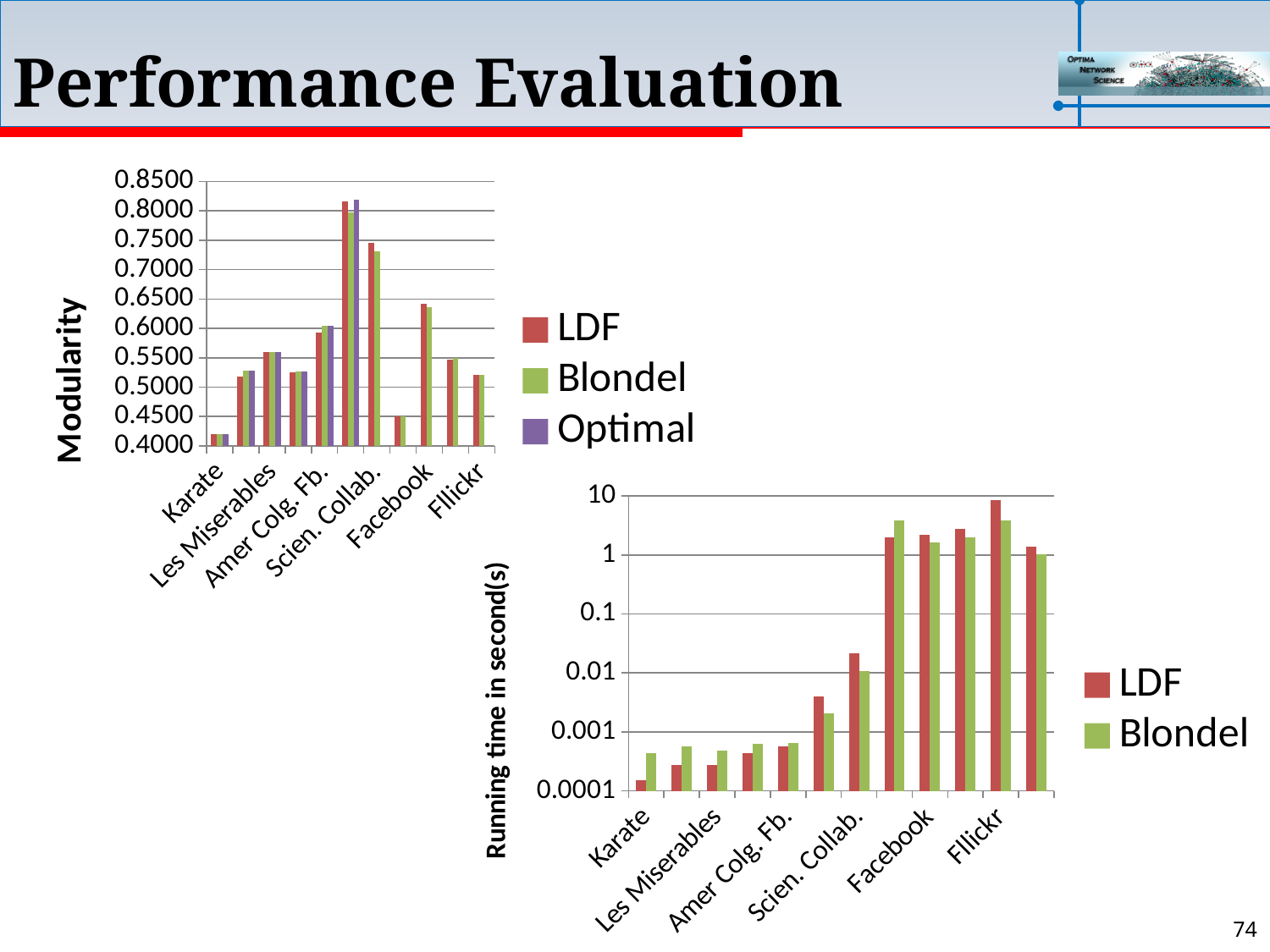
In the Running time chart, which category has the lowest LDF running time? Karate In the Modularity chart, is the LDF value for Scien. Collab. greater or less than 0.8000? less What kind of chart is the Modularity chart on the left? bar chart In the Running time chart, which category has the highest LDF running time? Fllickr What is the y-axis label of the Running time chart? Running time in second(s) In the Running time chart, is the LDF running time for Karate greater or less than 0.001? less In the Modularity chart, is the LDF value for Facebook greater or less than 0.6000? greater In the Running time chart, which is larger for Fllickr, the LDF or the Blondel running time? LDF How many series does the legend of the Modularity chart list? 3 How many series does the legend of the Running time chart list? 2